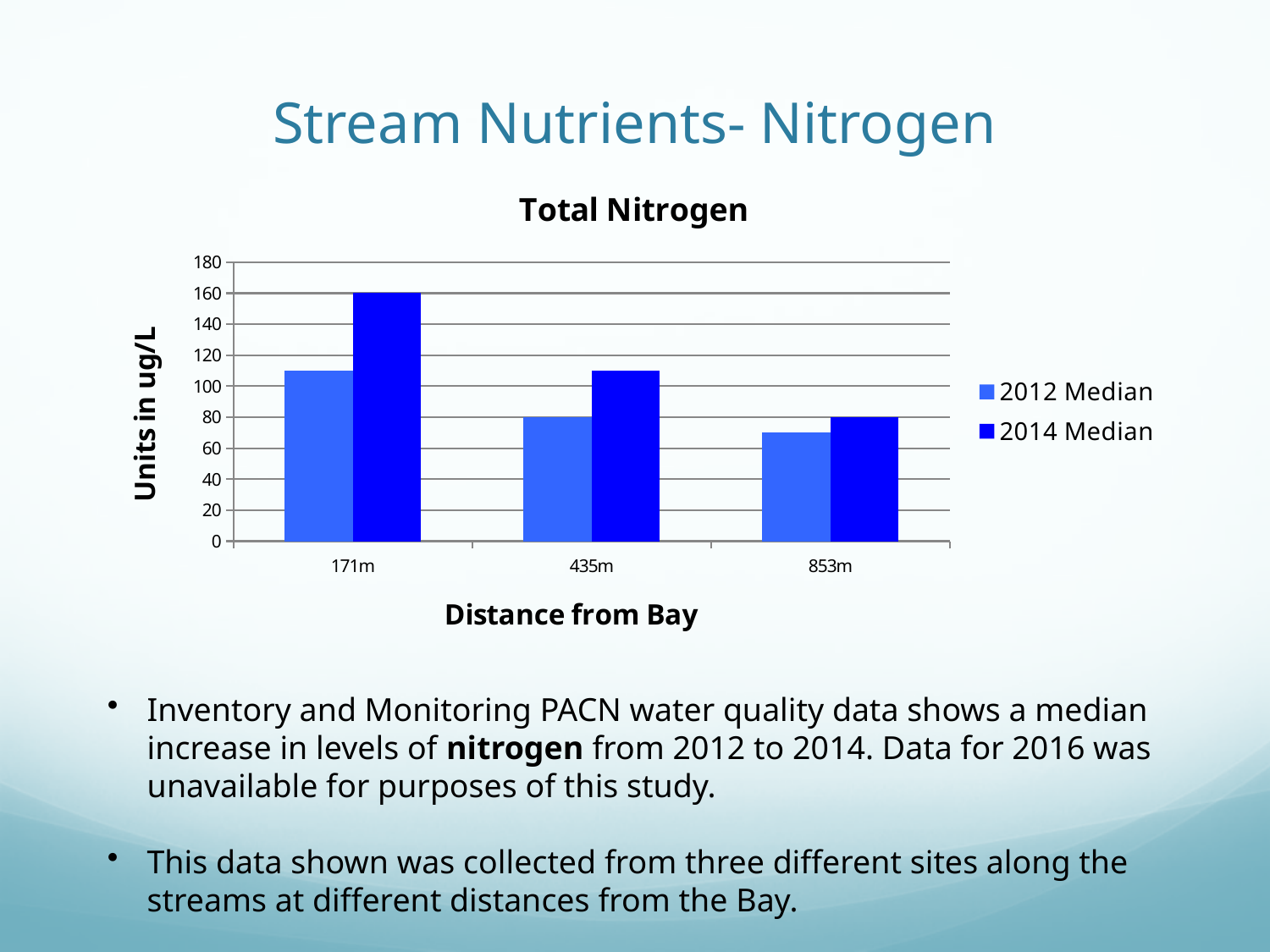
How many series does the legend list? 2 What is the 2014 Median value at 853m? 80 What is the 2014 Median value at 171m? 160 Is the 2012 Median value at 853m greater or less than 80? less What is the title of the chart? Total Nitrogen What kind of chart is shown on the slide? bar chart Which is larger at 435m, the 2012 Median or the 2014 Median? 2014 Median How many distance categories are shown on the x axis? 3 Which distance has the highest 2014 Median value? 171m Is the 2012 Median value at 171m greater or less than 100? greater What is the 2012 Median value at 435m? 80 Which distance has the lowest 2012 Median value? 853m